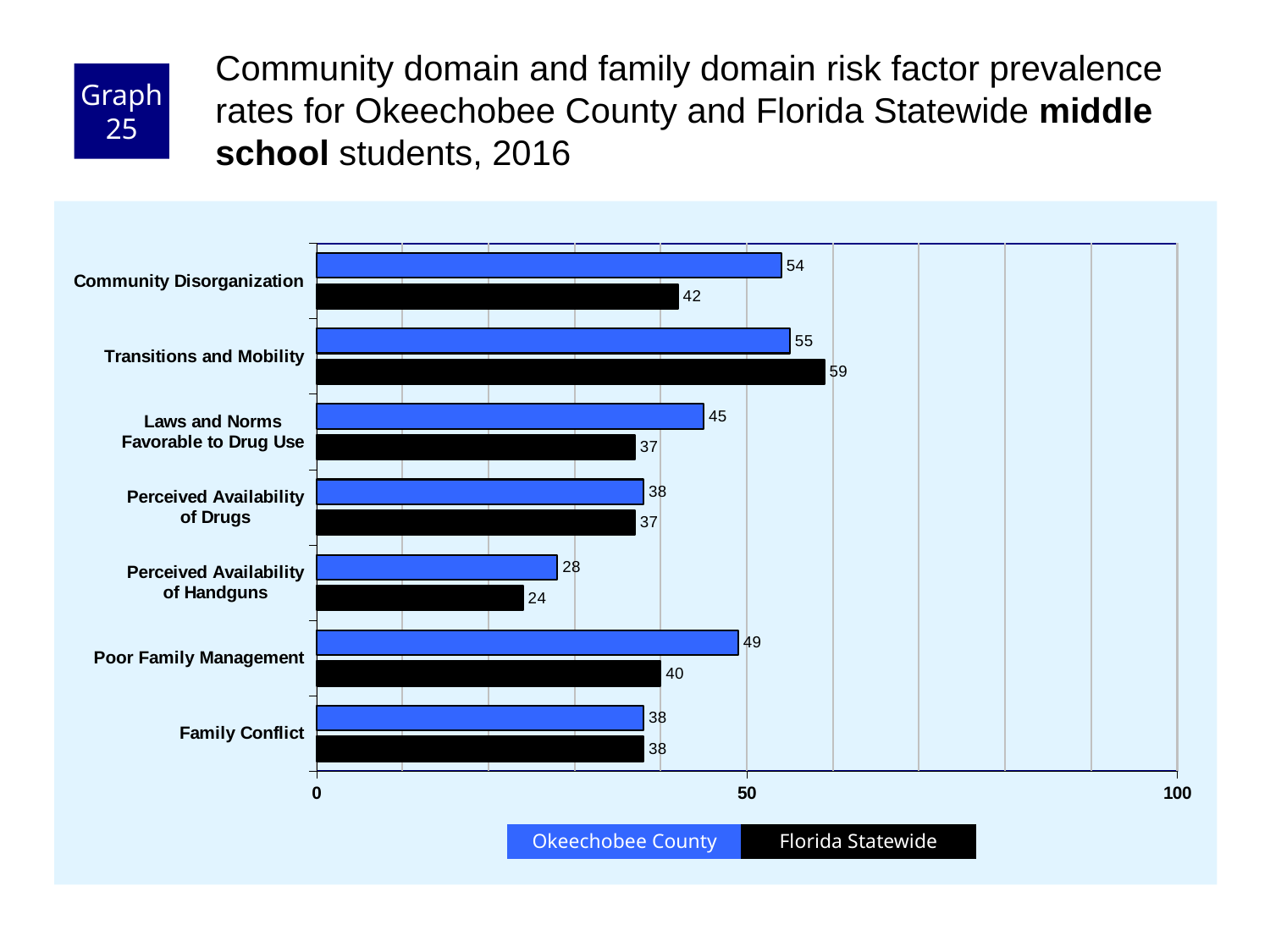
Is the Okeechobee County value for Poor Family Management greater or less than 50? less What is the difference between the Okeechobee County and Florida Statewide values for Community Disorganization? 12 How many risk factor categories are shown on the chart? 7 Which risk factor has the lowest Florida Statewide value? Perceived Availability of Handguns What is the Florida Statewide value for Perceived Availability of Handguns? 24 What is the Florida Statewide value for Transitions and Mobility? 59 Which colour represents Florida Statewide in the chart? black What is the Okeechobee County value for Community Disorganization? 54 What kind of chart is shown on the slide? bar chart For Transitions and Mobility, which is larger: the Okeechobee County value or the Florida Statewide value? Florida Statewide Which risk factor has the highest Okeechobee County value? Transitions and Mobility How many series does the legend list? 2